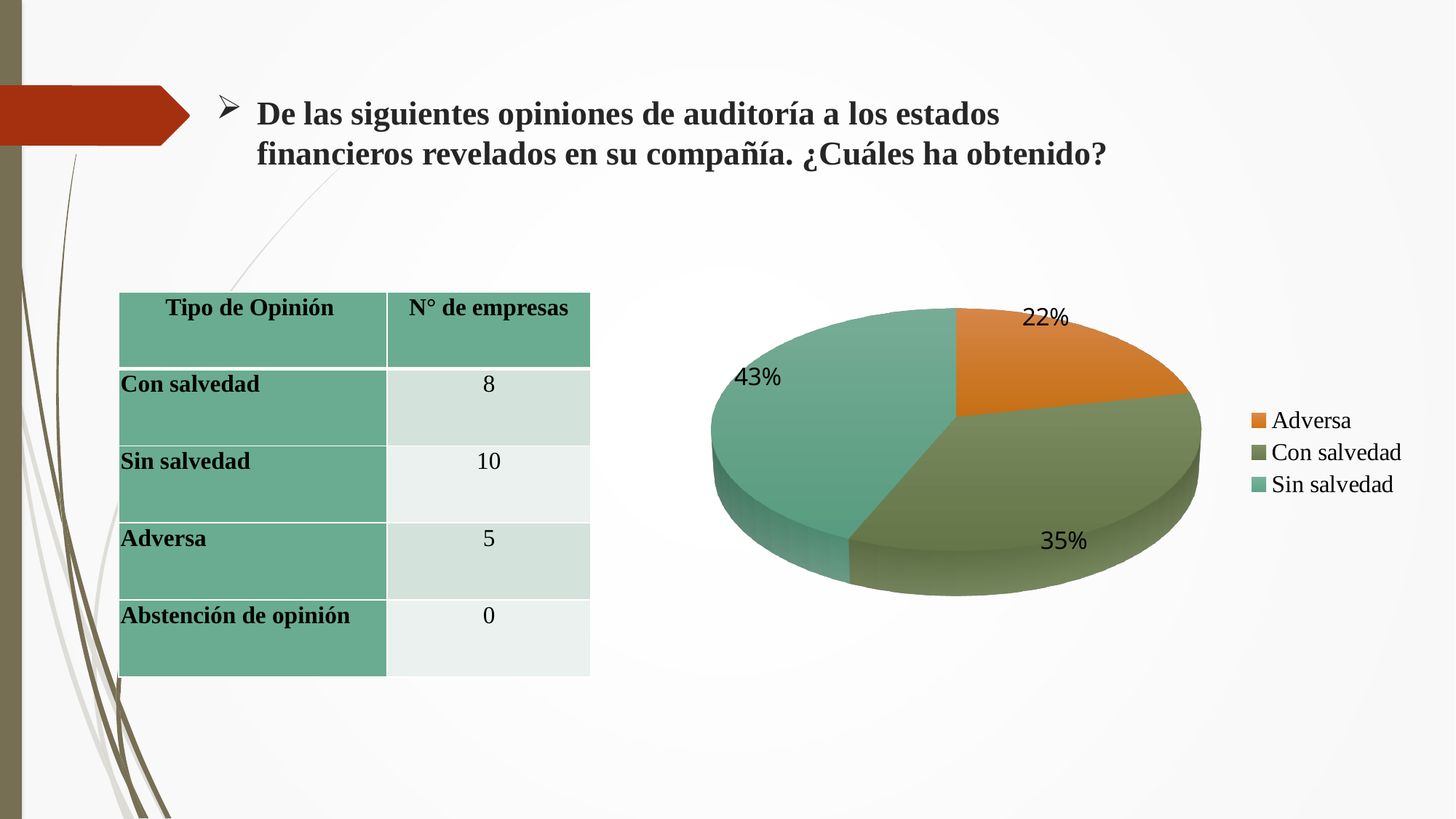
What share of the pie does Con salvedad represent? 35% What share of the pie does Adversa represent? 22% Which slice of the pie chart is the smallest? Adversa What colour is the Adversa slice in the pie chart? orange What kind of chart is shown on the slide? pie chart What share of the pie does Sin salvedad represent? 43% Which slice is larger, Con salvedad or Adversa? Con salvedad What is the difference in percentage points between the Sin salvedad slice and the Adversa slice? 21% Which legend entry is listed first in the pie chart's legend? Adversa How many entries does the legend of the pie chart list? 3 Which slice of the pie chart is the largest? Sin salvedad How many slices does the pie chart have? 3